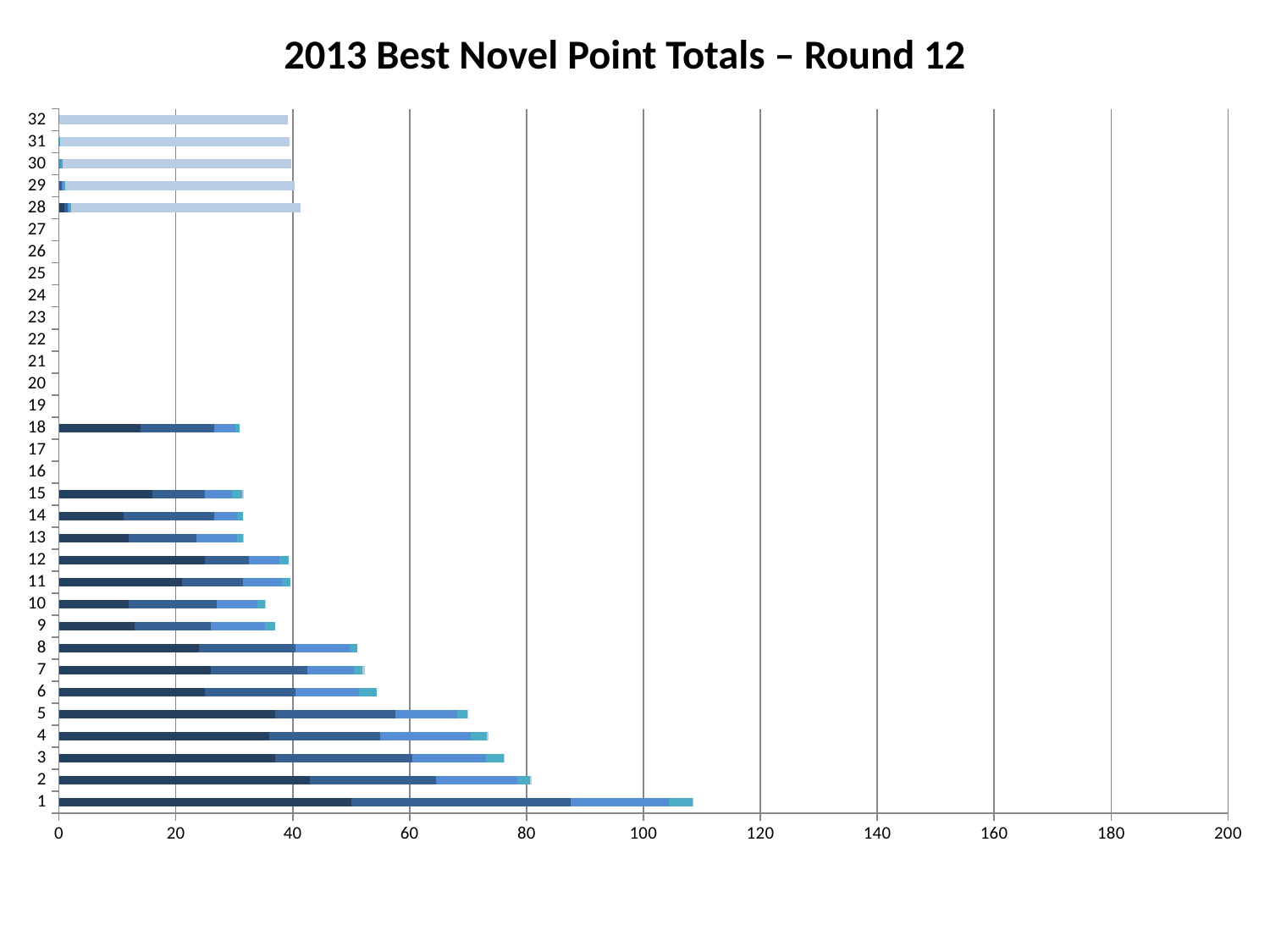
Is the total value for category 5 greater or less than 60? greater Which has the larger total, category 8 or category 5? 5 How many categories are listed on the vertical axis of the chart? 32 Is the total value for category 6 greater or less than 60? less What is the title of the chart? 2013 Best Novel Point Totals – Round 12 Which category has the longest bar in the chart? 1 Which has the larger total, category 1 or category 2? 1 Is the total value for category 1 greater or less than 100? greater What kind of chart is shown on the slide? bar chart What is the highest value shown on the horizontal axis? 200